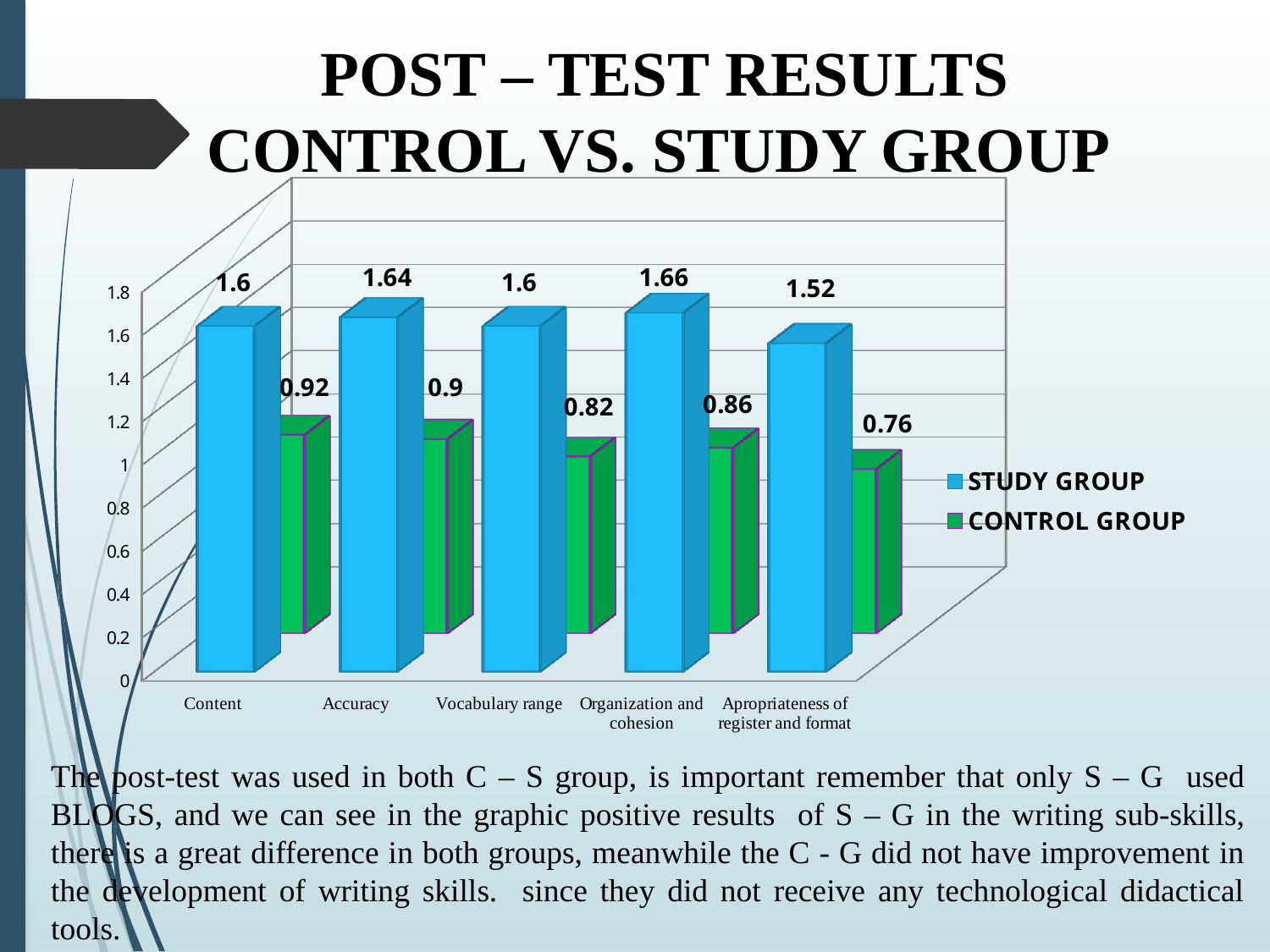
What is the difference between the CONTROL GROUP values for Content and Appropriateness of register and format? 0.16 What is the STUDY GROUP value for Accuracy? 1.64 What is the CONTROL GROUP value for Appropriateness of register and format? 0.76 What is the CONTROL GROUP value for Vocabulary range? 0.82 Which is larger for Organization and cohesion: the STUDY GROUP value or the CONTROL GROUP value? STUDY GROUP Which category has the highest STUDY GROUP value? Organization and cohesion How many series does the legend list? 2 How many categories are shown on the x axis? 5 Which category has the lowest CONTROL GROUP value? Appropriateness of register and format What kind of chart is shown on the slide? Bar chart Which series is shown in green? CONTROL GROUP What is the difference between the STUDY GROUP and CONTROL GROUP values for Content? 0.68